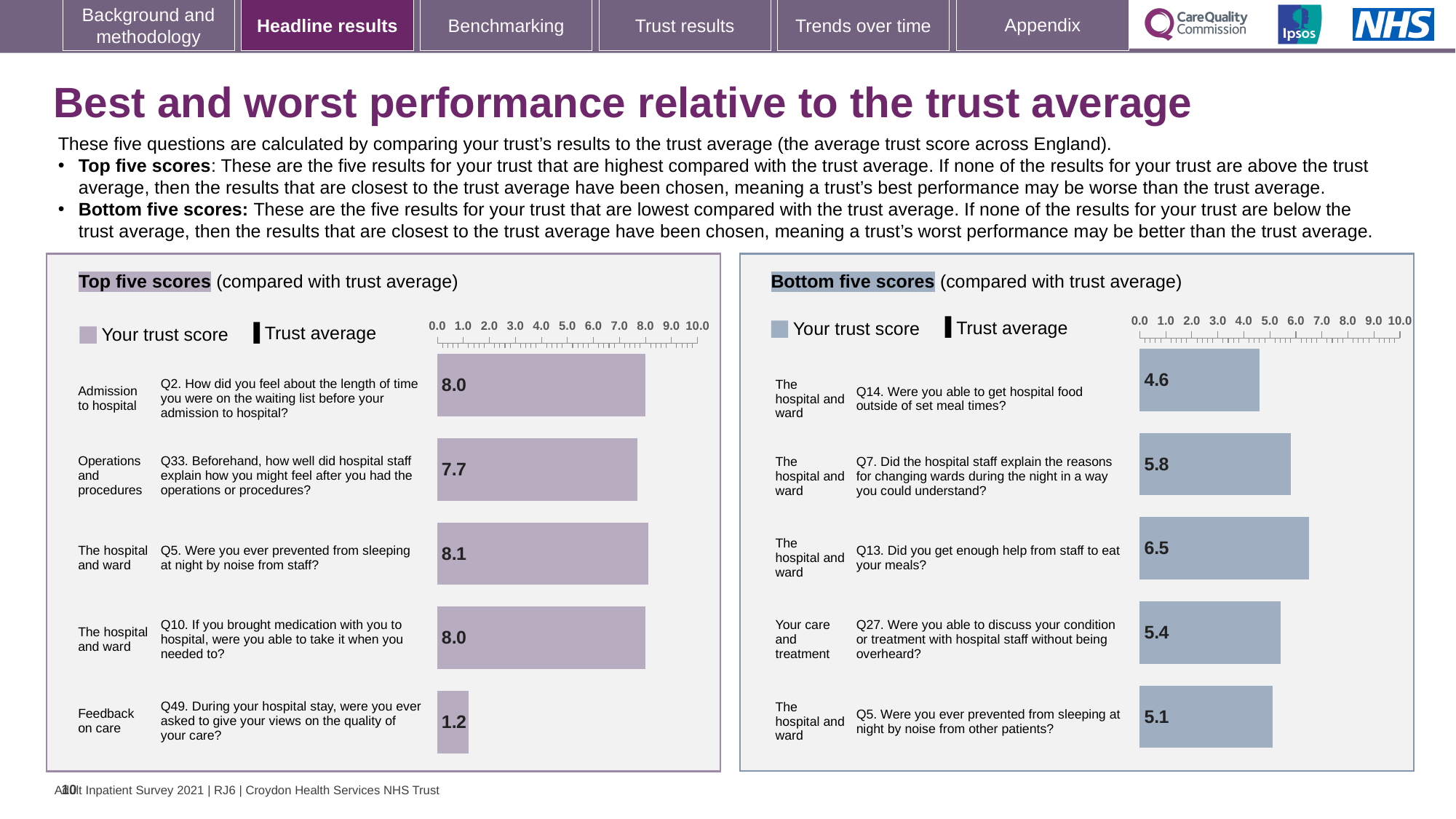
In the Top five scores chart, what is the trust score for Q49 (asked to give your views on the quality of your care)? 1.2 In the Bottom five scores chart, which question has the lowest trust score? Q14 In the Top five scores chart, what is the difference between the scores for Q5 and Q33? 0.4 In the Bottom five scores chart, is the score for Q7 greater or less than 5.0? greater In the Top five scores chart, which question has the lowest trust score? Q49 In the Bottom five scores chart, what is the difference between the scores for Q13 and Q5? 1.4 In the Top five scores chart, what is the trust score for Q5 (prevented from sleeping at night by noise from staff)? 8.1 What kind of chart is used in the Top five scores panel? Bar chart In the Bottom five scores chart, what is the trust score for Q14 (hospital food outside of set meal times)? 4.6 In the Bottom five scores chart, which question has the highest trust score? Q13 In the Bottom five scores chart, what is the trust score for Q27 (discuss your condition without being overheard)? 5.4 In the Top five scores chart, which question has the highest trust score? Q5